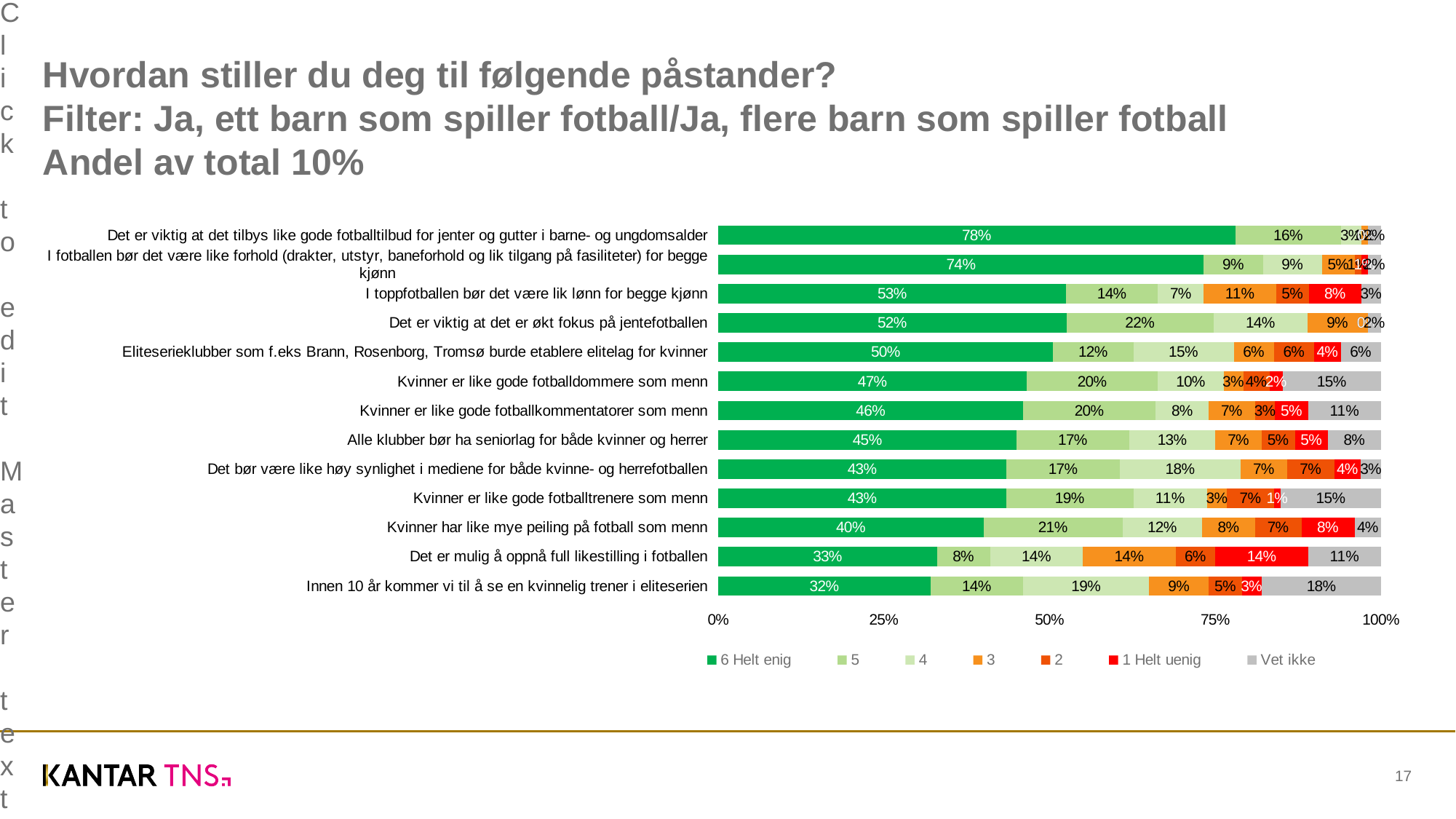
What kind of chart is shown on the slide? Stacked bar chart What is the value for series '5' for 'Det er viktig at det er økt fokus på jentefotballen'? 22% Which has the larger '6 Helt enig' share: 'Kvinner er like gode fotballdommere som menn' or 'Kvinner er like gode fotballtrenere som menn'? Kvinner er like gode fotballdommere som menn What is the '1 Helt uenig' value for 'Det er mulig å oppnå full likestilling i fotballen'? 14% What is the first entry listed in the legend? 6 Helt enig What is the 'Vet ikke' value for 'Innen 10 år kommer vi til å se en kvinnelig trener i eliteserien'? 18% Which statement has the lowest '6 Helt enig' share? Innen 10 år kommer vi til å se en kvinnelig trener i eliteserien What is the difference in '6 Helt enig' share between 'Det er viktig at det tilbys like gode fotballtilbud for jenter og gutter i barne- og ungdomsalder' and 'I fotballen bør det være like forhold (drakter, utstyr, baneforhold og lik tilgang på fasiliteter) for begge kjønn'? 4 percentage points Which statement has the highest '6 Helt enig' share? Det er viktig at det tilbys like gode fotballtilbud for jenter og gutter i barne- og ungdomsalder How many series does the legend list? 7 What is the '6 Helt enig' value for 'Det er mulig å oppnå full likestilling i fotballen'? 33% How many statements (categories) are plotted in the chart? 13